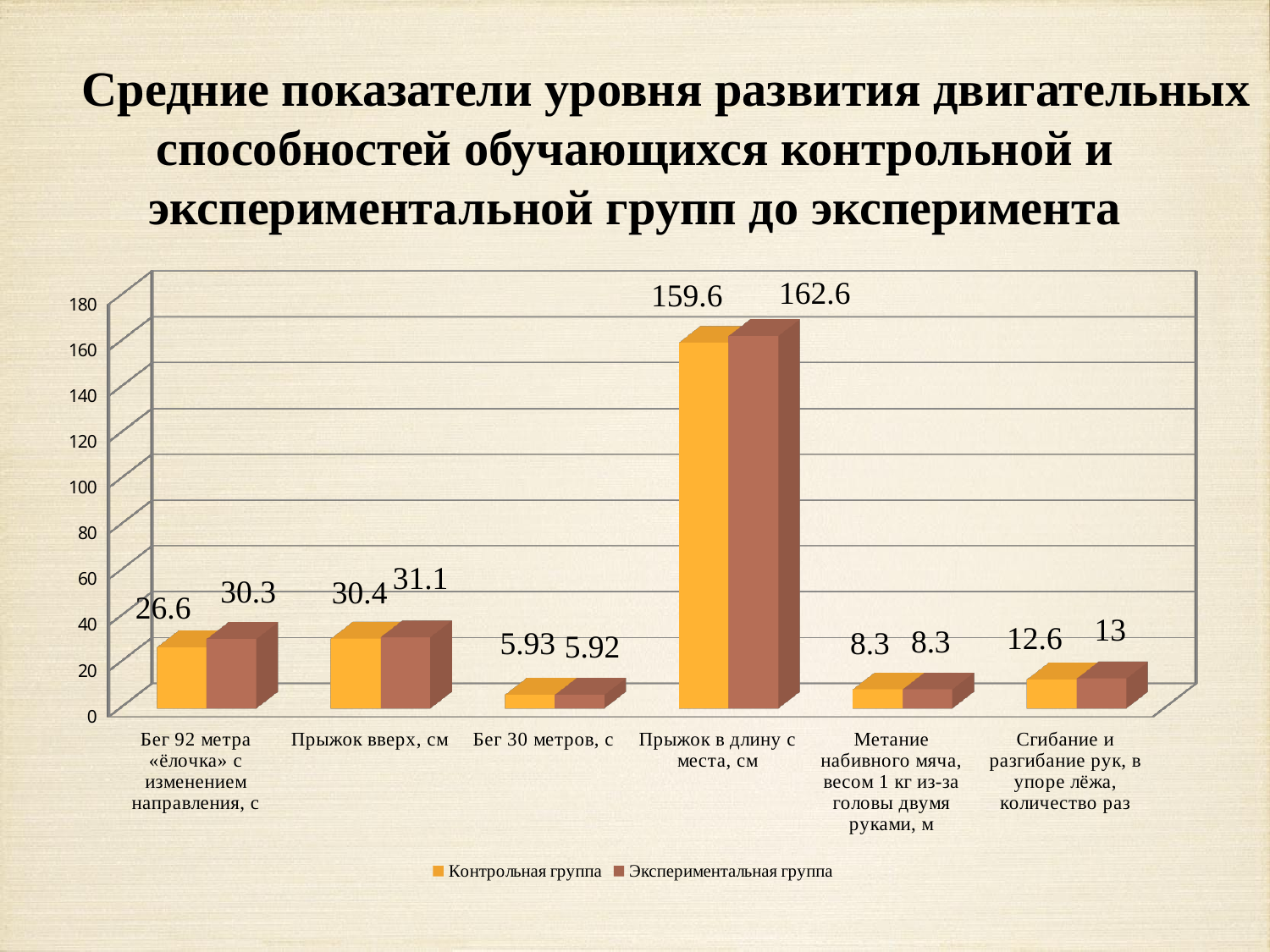
What is the value for the Экспериментальная группа in the category «Сгибание и разгибание рук, в упоре лёжа, количество раз»? 13 What is the value for the Экспериментальная группа in the category «Бег 92 метра «ёлочка» с изменением направления, с»? 30.3 Which category has the highest value for the Экспериментальная группа? Прыжок в длину с места, см What kind of chart is shown on the slide? Bar chart Which category has the lowest value for the Контрольная группа? Бег 30 метров, с What is the value for the Контрольная группа in the category «Бег 30 метров, с»? 5.93 In the category «Прыжок вверх, см», which group has the larger value? Экспериментальная группа What is the difference between the Экспериментальная группа and Контрольная группа values in the category «Прыжок в длину с места, см»? 3 What is the difference between the Экспериментальная группа and Контрольная группа values in the category «Бег 92 метра «ёлочка» с изменением направления, с»? 3.7 How many categories are shown on the x axis of the chart? 6 How many series does the chart legend list? 2 What is the value for the Контрольная группа in the category «Прыжок в длину с места, см»? 159.6